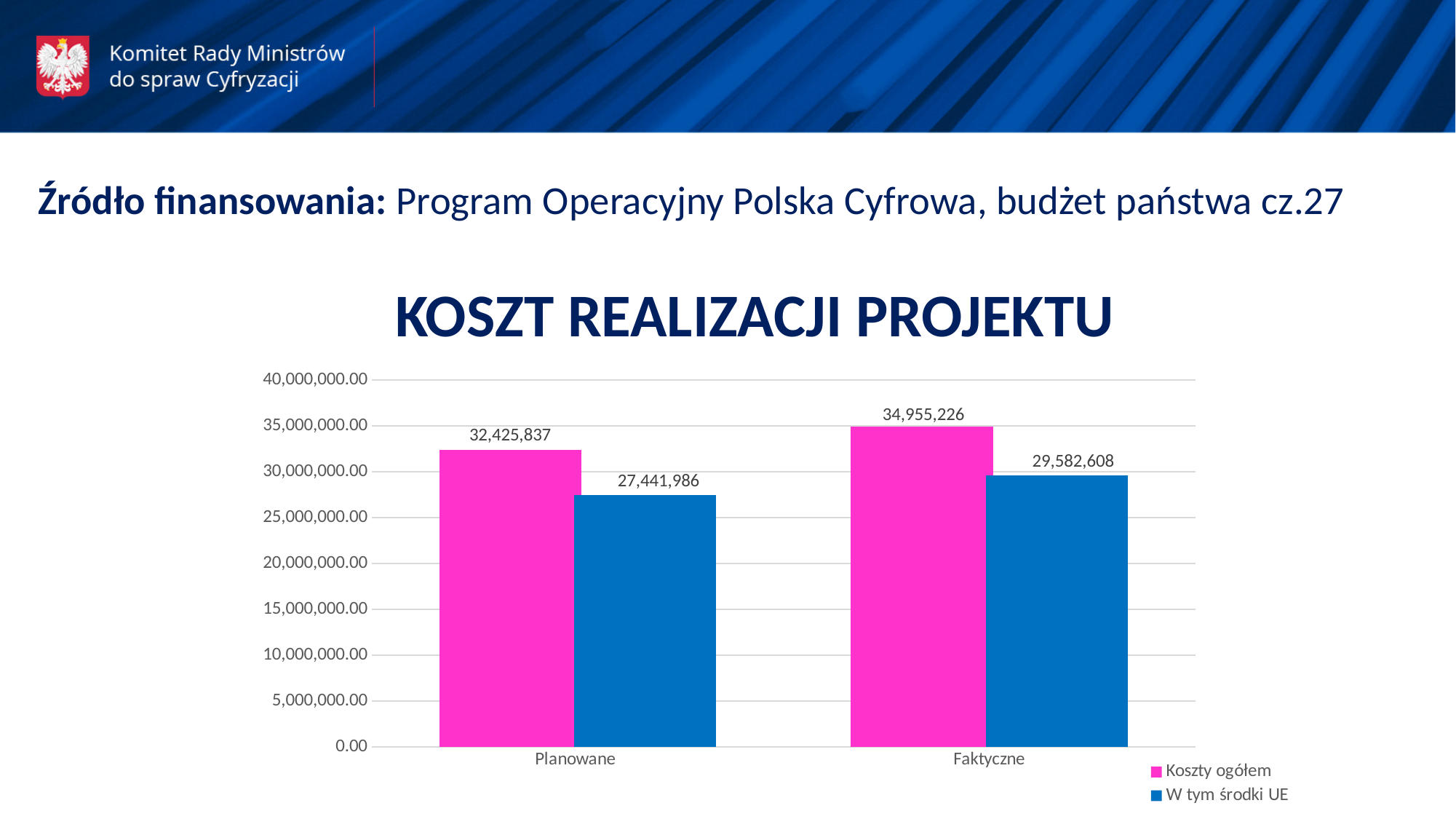
Which category has the higher Koszty ogółem value? Faktyczne How many categories are shown on the x axis? 2 What is the value of Koszty ogółem for Faktyczne? 34,955,226 Is the W tym środki UE value for Faktyczne greater or less than 30,000,000.00? less What is the difference between Koszty ogółem and W tym środki UE for Planowane? 4,983,851 What is the value of Koszty ogółem for Planowane? 32,425,837 How many series does the legend list? 2 What is the value of W tym środki UE for Planowane? 27,441,986 What is the value of W tym środki UE for Faktyczne? 29,582,608 Which category has the lower W tym środki UE value? Planowane What is the difference between Koszty ogółem for Faktyczne and Koszty ogółem for Planowane? 2,529,389 What type of chart is shown on the slide? bar chart